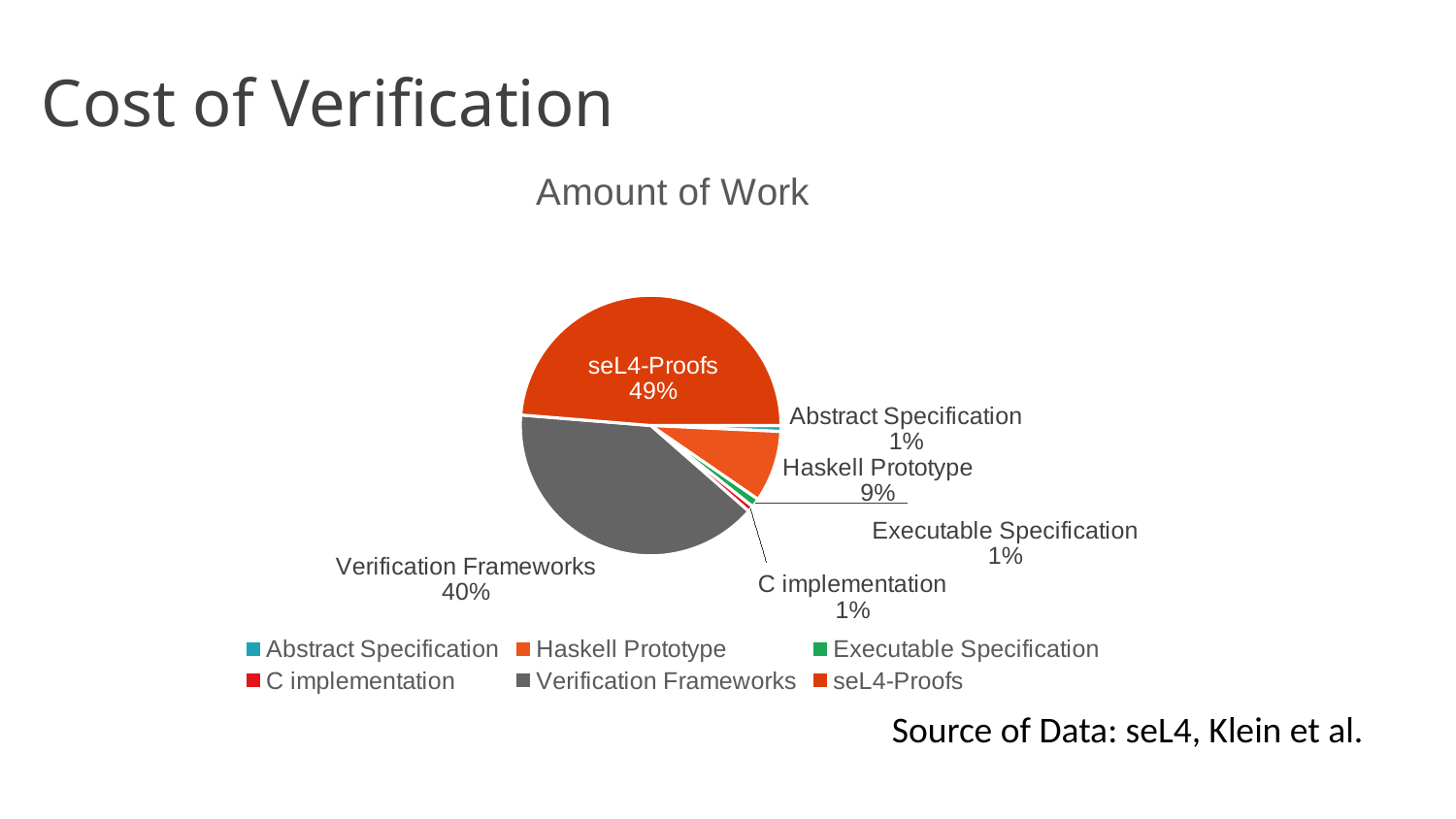
What share of the pie does Verification Frameworks account for? 40% Which is larger, the Haskell Prototype slice or the Verification Frameworks slice? Verification Frameworks What is the title of the chart? Amount of Work What kind of chart is shown on the slide? Pie chart Which category has the largest slice of the pie? seL4-Proofs What is the difference between the seL4-Proofs share and the Verification Frameworks share? 9% What is the value shown for Haskell Prototype? 9% How many categories are shown in the pie chart? 6 What is the difference between the Haskell Prototype share and the C implementation share? 8% What is the value shown for Abstract Specification? 1% What share of the pie does seL4-Proofs account for? 49% How many entries does the legend list? 6